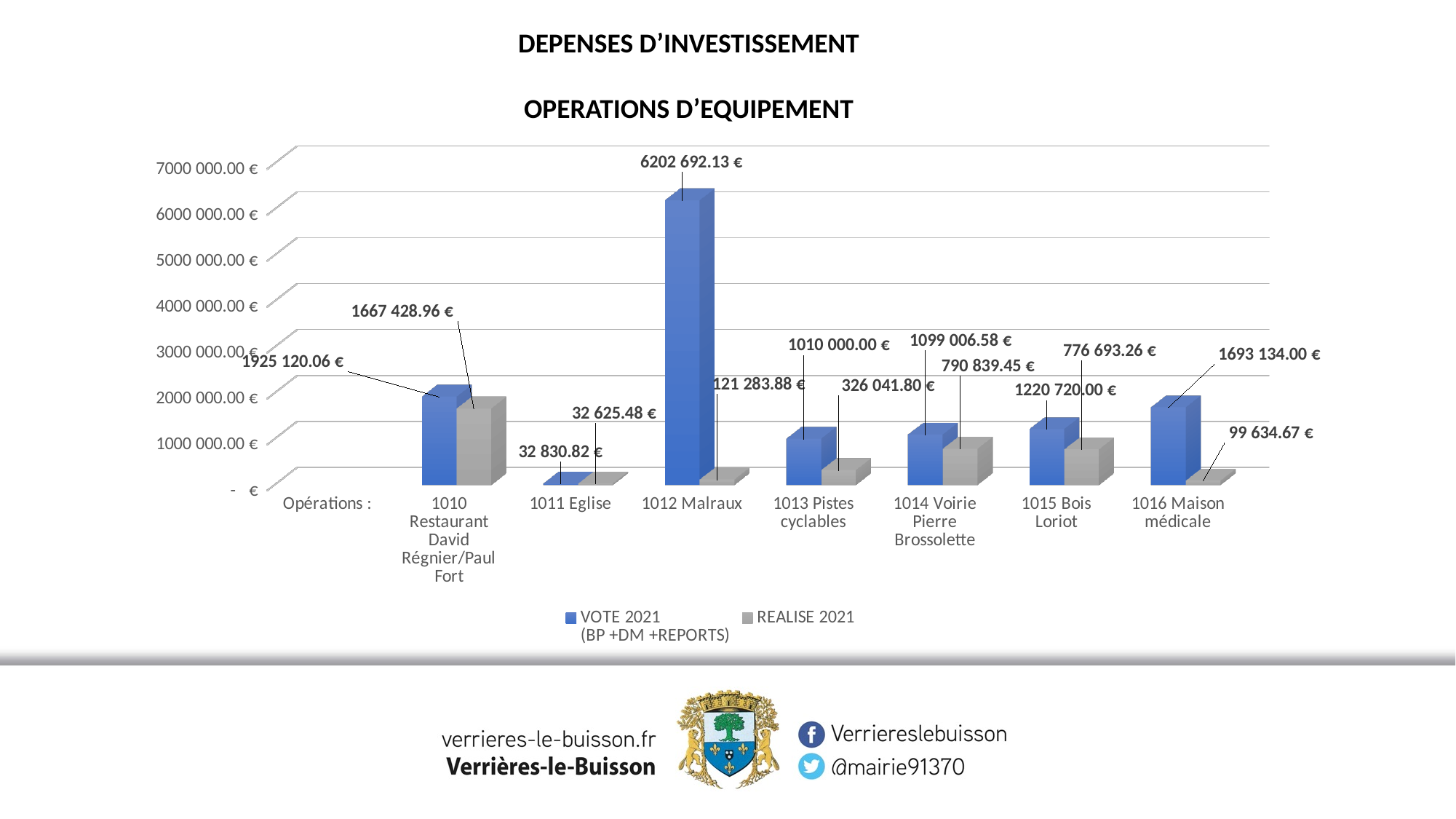
How many series does the legend list? 2 Which operation has the highest VOTE 2021 (BP +DM +REPORTS) value? 1012 Malraux Is the VOTE 2021 value for 1010 Restaurant David Régnier/Paul Fort greater or less than 1000 000.00 €? greater Which colour represents the REALISE 2021 series? grey What kind of chart is shown on the slide? bar chart What is the REALISE 2021 value for 1014 Voirie Pierre Brossolette? 790 839.45 € What is the VOTE 2021 (BP +DM +REPORTS) value for 1012 Malraux? 6202 692.13 € What is the difference between the VOTE 2021 and REALISE 2021 values for 1011 Eglise? 205.34 € Which is larger: the REALISE 2021 value for 1013 Pistes cyclables or for 1014 Voirie Pierre Brossolette? 1014 Voirie Pierre Brossolette Which operation has the highest REALISE 2021 value? 1010 Restaurant David Régnier/Paul Fort What is the REALISE 2021 value for 1016 Maison médicale? 99 634.67 € Which operation has the lowest REALISE 2021 value? 1011 Eglise